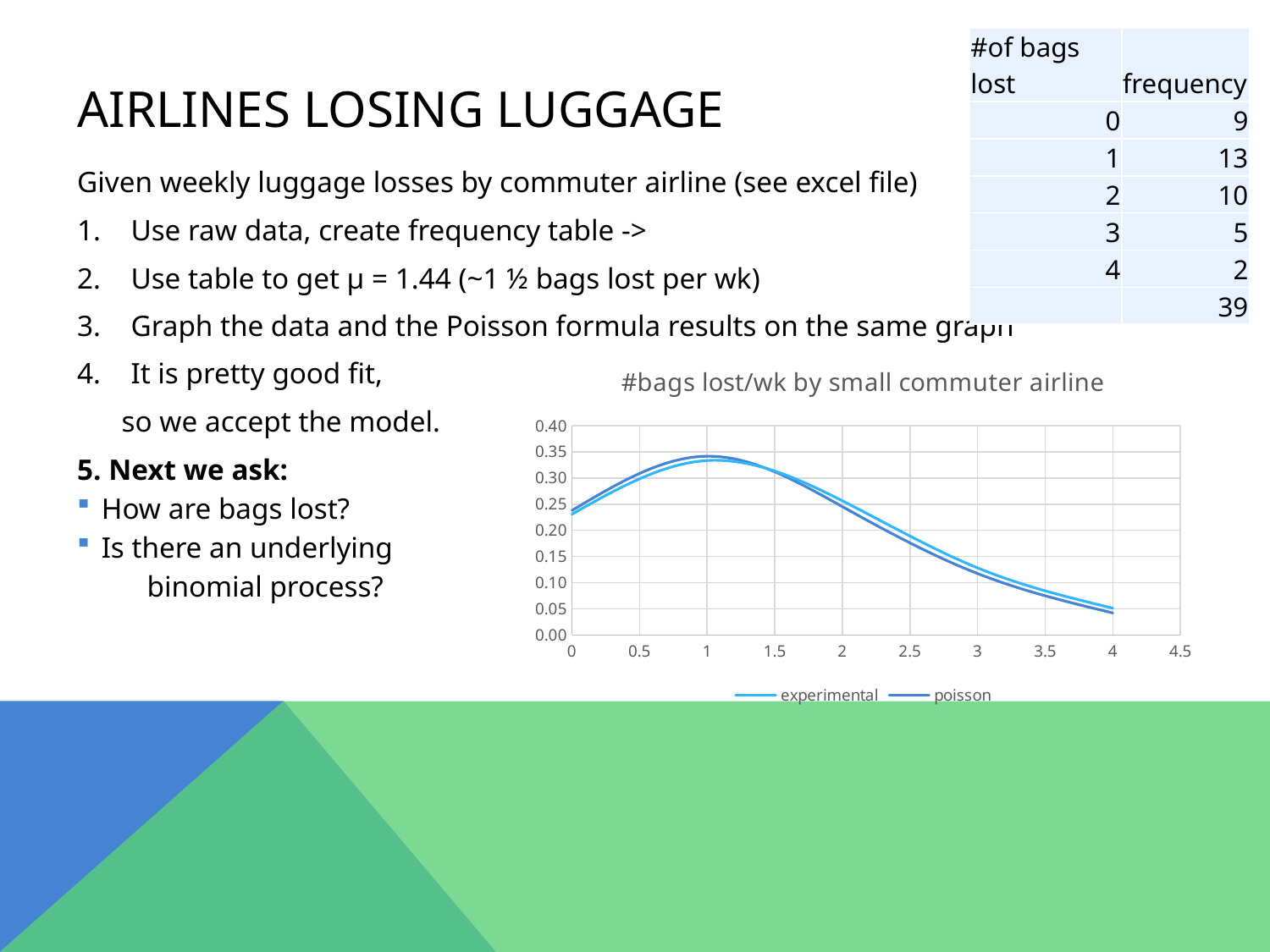
Is the value of the experimental series at x = 0 greater or less than 0.20? greater What are the two series named in the chart's legend? experimental and poisson Is the value of the experimental series at x = 1 greater or less than 0.30? greater Is the value of the experimental series at x = 2 greater or less than 0.20? greater Do the values of the experimental series rise or fall between x = 1 and x = 4? fall What kind of chart is shown on the slide? line chart What is the title of the chart? #bags lost/wk by small commuter airline Do the values of the poisson series rise or fall between x = 0 and x = 1? rise How many series does the chart's legend list? 2